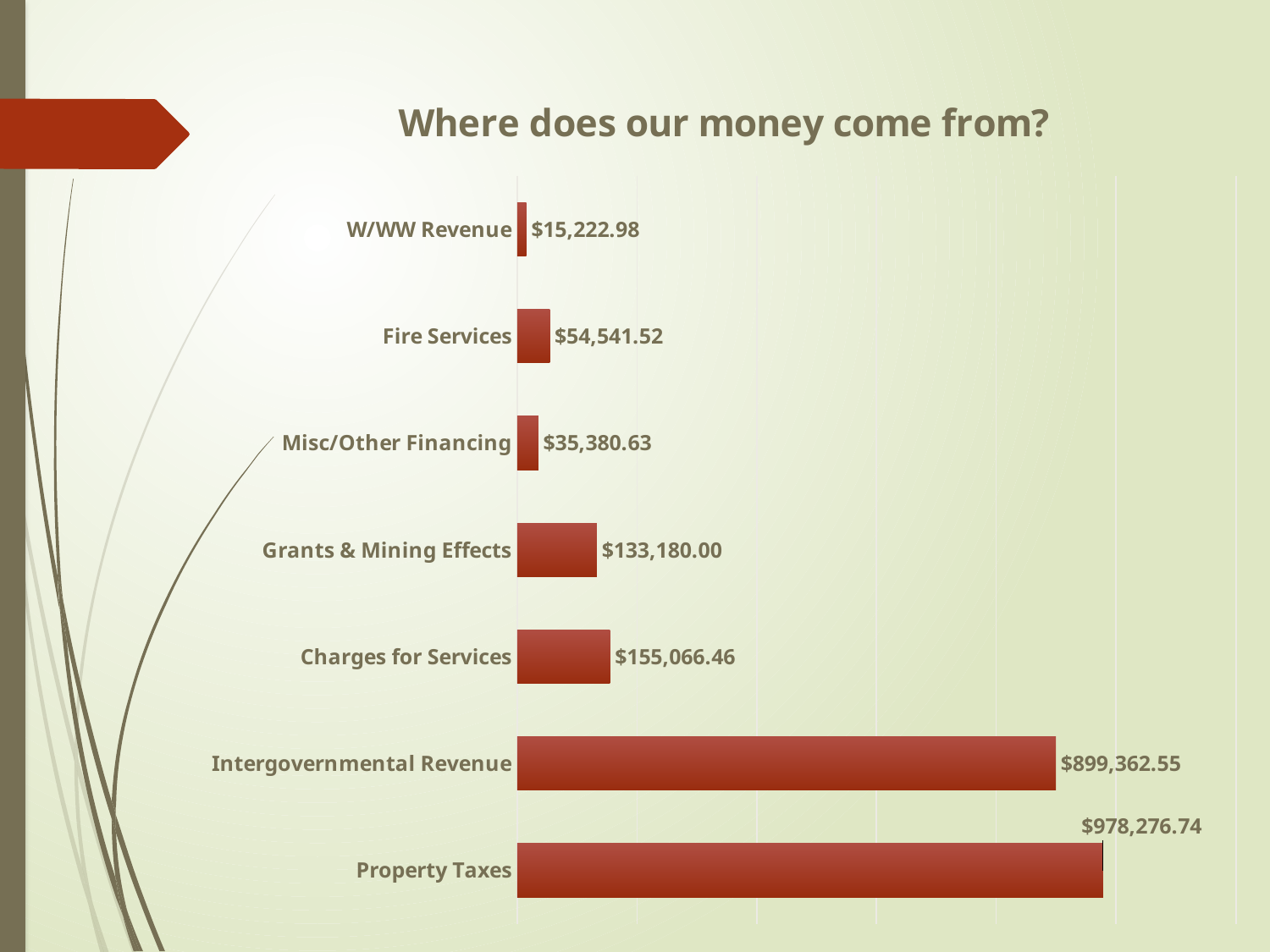
Which category has the lowest value? W/WW Revenue What is the title of the chart? Where does our money come from? How many categories are shown in the chart? 7 What is the value for Property Taxes? $978,276.74 What is the difference between Charges for Services and Grants & Mining Effects? $21,886.46 Which is larger, Fire Services or Misc/Other Financing? Fire Services What is the value for Grants & Mining Effects? $133,180.00 What kind of chart is shown on the slide? Bar chart What is the value for W/WW Revenue? $15,222.98 What is the difference between Property Taxes and Intergovernmental Revenue? $78,914.19 What is the value for Intergovernmental Revenue? $899,362.55 Which category has the highest value? Property Taxes